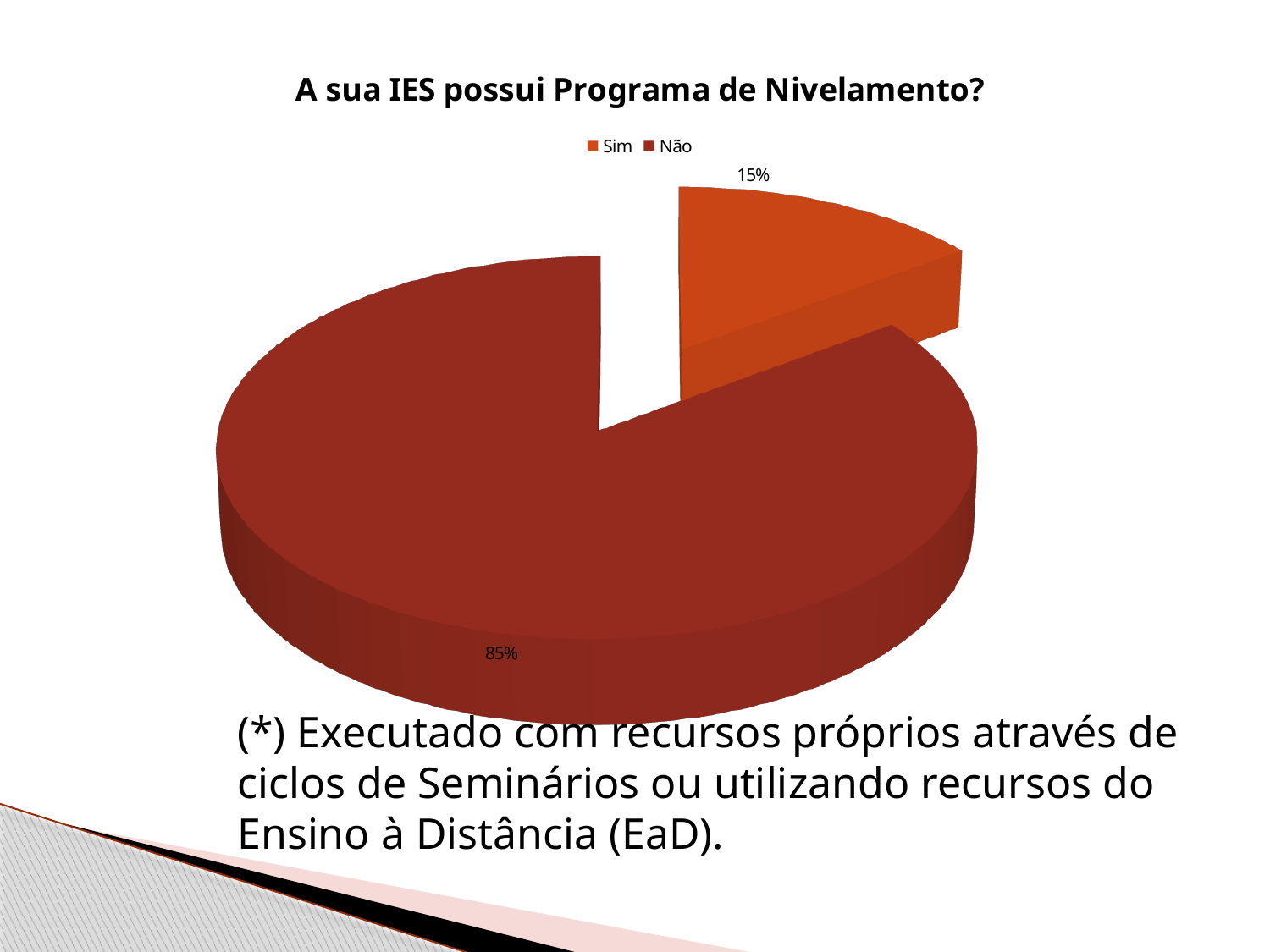
What kind of chart is shown on the slide? Pie chart What share of the pie does the "Não" slice represent? 85% Which legend entry is shown in the darker red colour? Não Which category has the smallest slice of the pie? Sim Which category has the largest slice of the pie? Não How many entries does the legend list? 2 How many slices does the pie chart have? 2 What is the title of the chart? A sua IES possui Programa de Nivelamento? What share of the pie does the "Sim" slice represent? 15% What is the difference in percentage points between the "Não" and "Sim" slices? 70 Which slice is larger, "Sim" or "Não"? Não